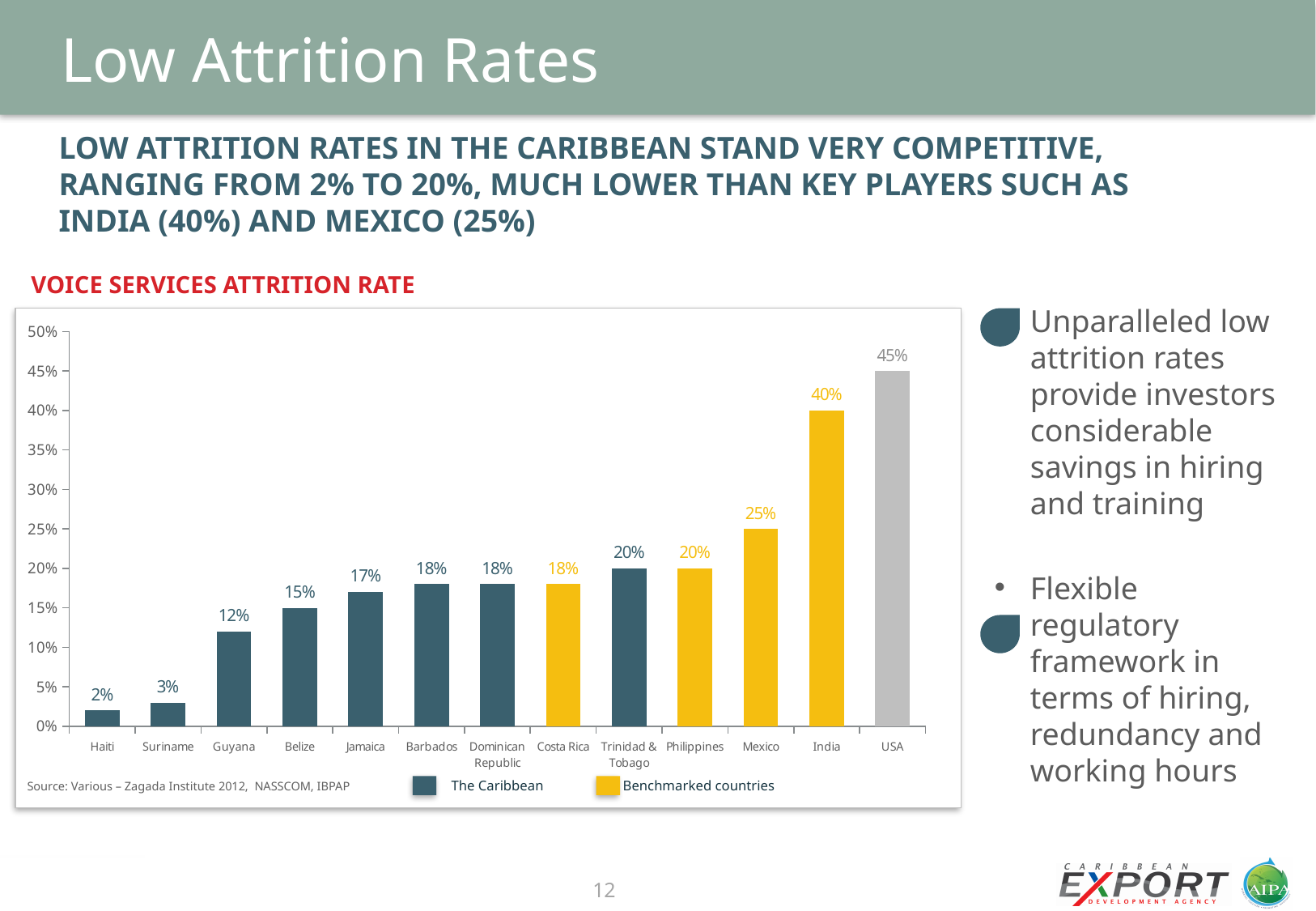
What is the voice services attrition rate for Haiti? 2% How many series does the chart legend list? 2 Which has a higher attrition rate, Guyana or Trinidad & Tobago? Trinidad & Tobago Which country has the highest voice services attrition rate on the chart? USA Which legend entry is shown in yellow? Benchmarked countries What is the voice services attrition rate for India? 40% Is the attrition rate for the USA greater or less than 40%? greater How many countries are shown on the voice services attrition rate chart? 13 Which country has the lowest voice services attrition rate on the chart? Haiti What is the difference between the attrition rates of Mexico and Belize? 10% What kind of chart is used to show the voice services attrition rate? Bar chart What is the voice services attrition rate for Jamaica? 17%